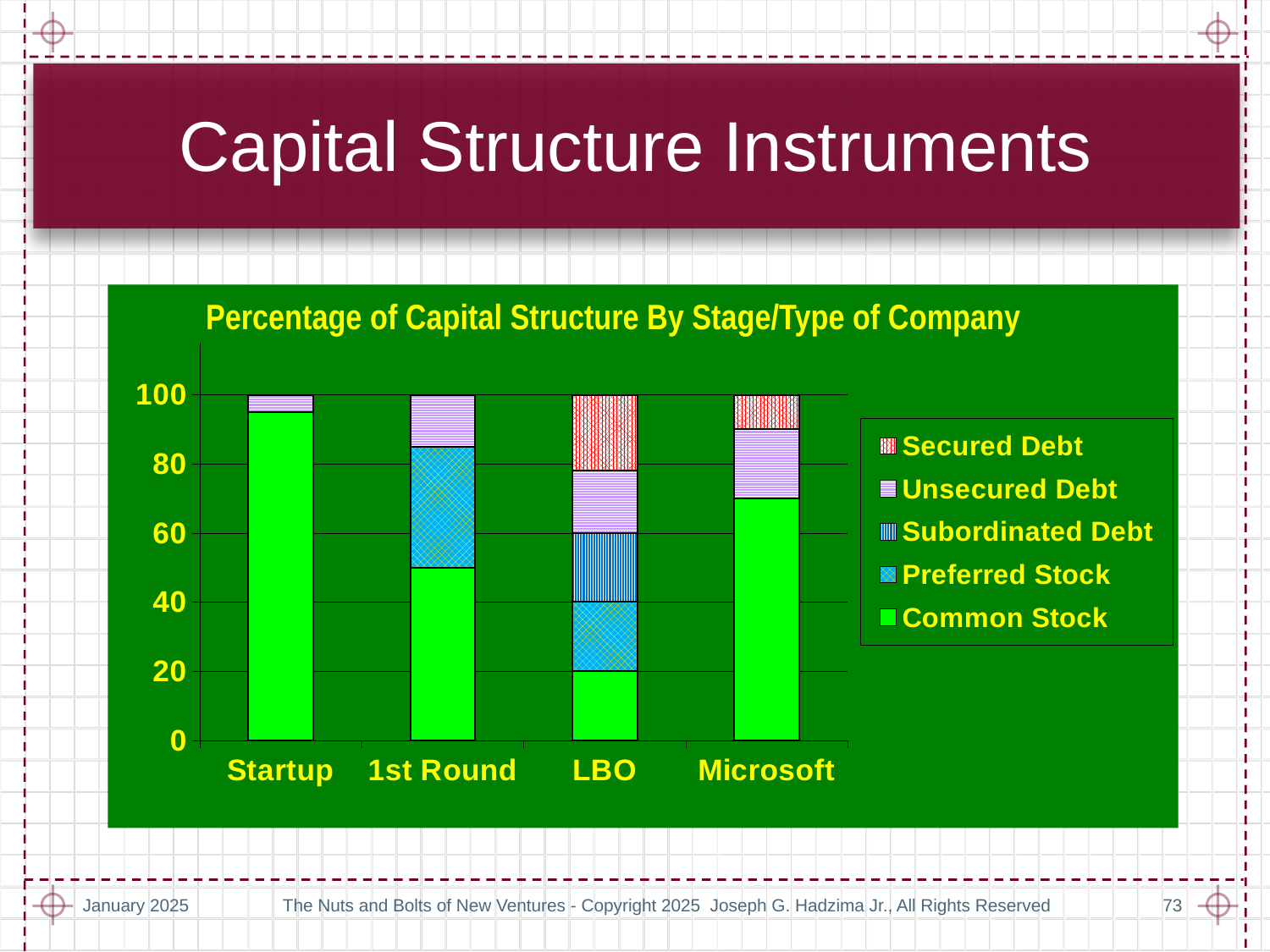
Which category is the only one that includes Subordinated Debt? LBO What kind of chart is shown on the slide? Stacked bar chart Is the Common Stock value for Microsoft greater or less than 60? greater Is the Common Stock value for Startup greater or less than 80? greater How many series does the chart's legend list? 5 Which category has the largest Common Stock share? Startup Which category has the smallest Common Stock share? LBO What is the title of the chart? Percentage of Capital Structure By Stage/Type of Company Which has a larger Common Stock share, Startup or Microsoft? Startup What is the total of the stacked bar for LBO? 100 How many categories are shown on the x axis of the chart? 4 Is the Common Stock value for 1st Round greater or less than 60? less